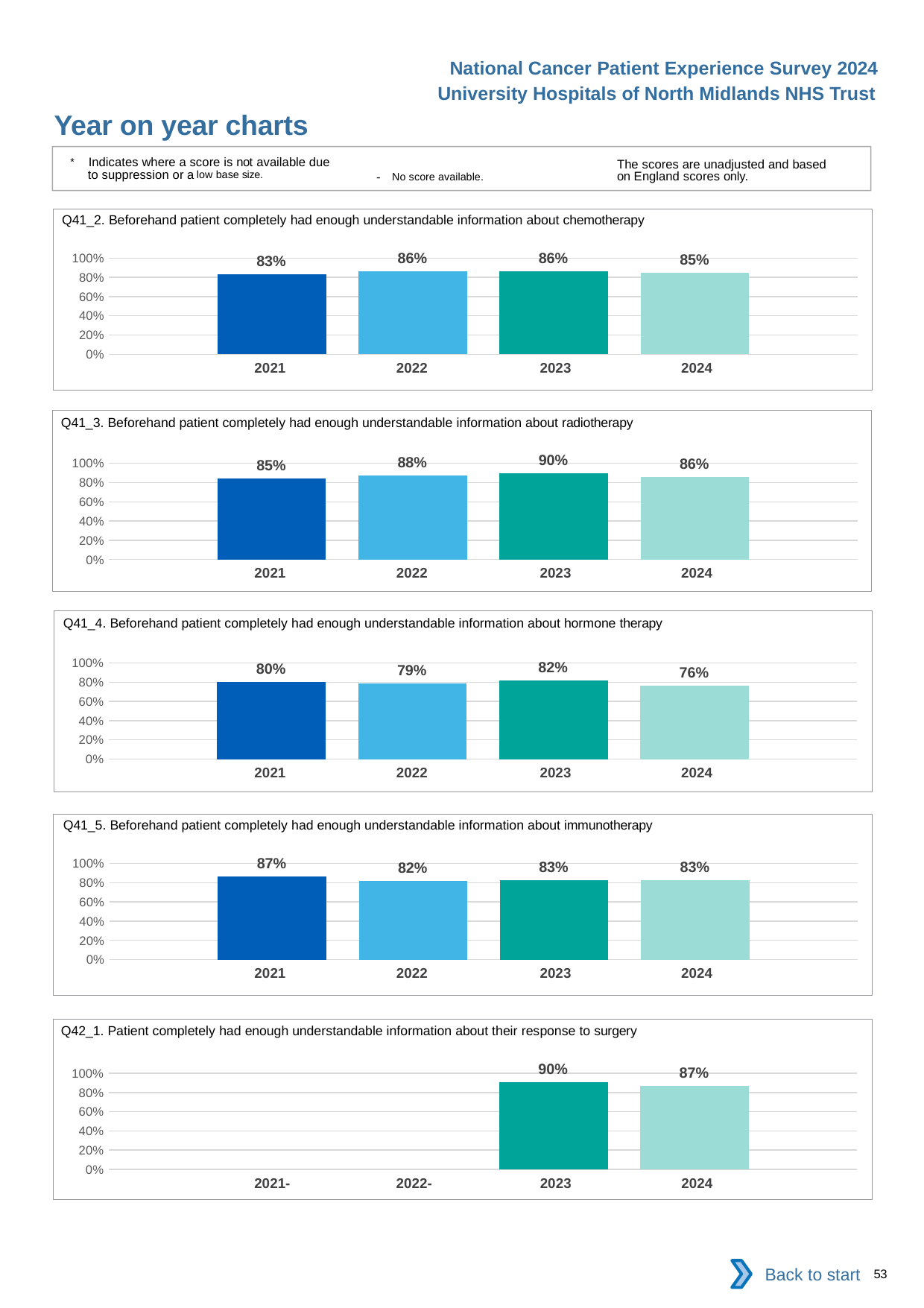
In the Q41_4 chart about hormone therapy, which year has the lowest value? 2024 In the Q42_1 chart about response to surgery, what is the value for 2024? 87% In the Q41_4 chart about hormone therapy, what is the value for 2023? 82% In the Q41_5 chart about immunotherapy, what is the difference between the 2021 and 2022 values? 5 percentage points In the Q41_3 chart about radiotherapy, which year has the highest value? 2023 What type of chart is the Q41_2 chart about chemotherapy? Bar chart In the Q41_5 chart about immunotherapy, which is larger, the value for 2021 or the value for 2022? 2021 In the Q41_3 chart about radiotherapy, what is the difference between the 2023 and 2024 values? 4 percentage points In the Q42_1 chart about response to surgery, how many years have a bar plotted? 2 In the Q41_4 chart about hormone therapy, is the value for 2024 greater or less than 80%? less In the Q41_2 chart about chemotherapy, what is the value for 2021? 83% In the Q41_2 chart about chemotherapy, how many years are shown on the x axis? 4